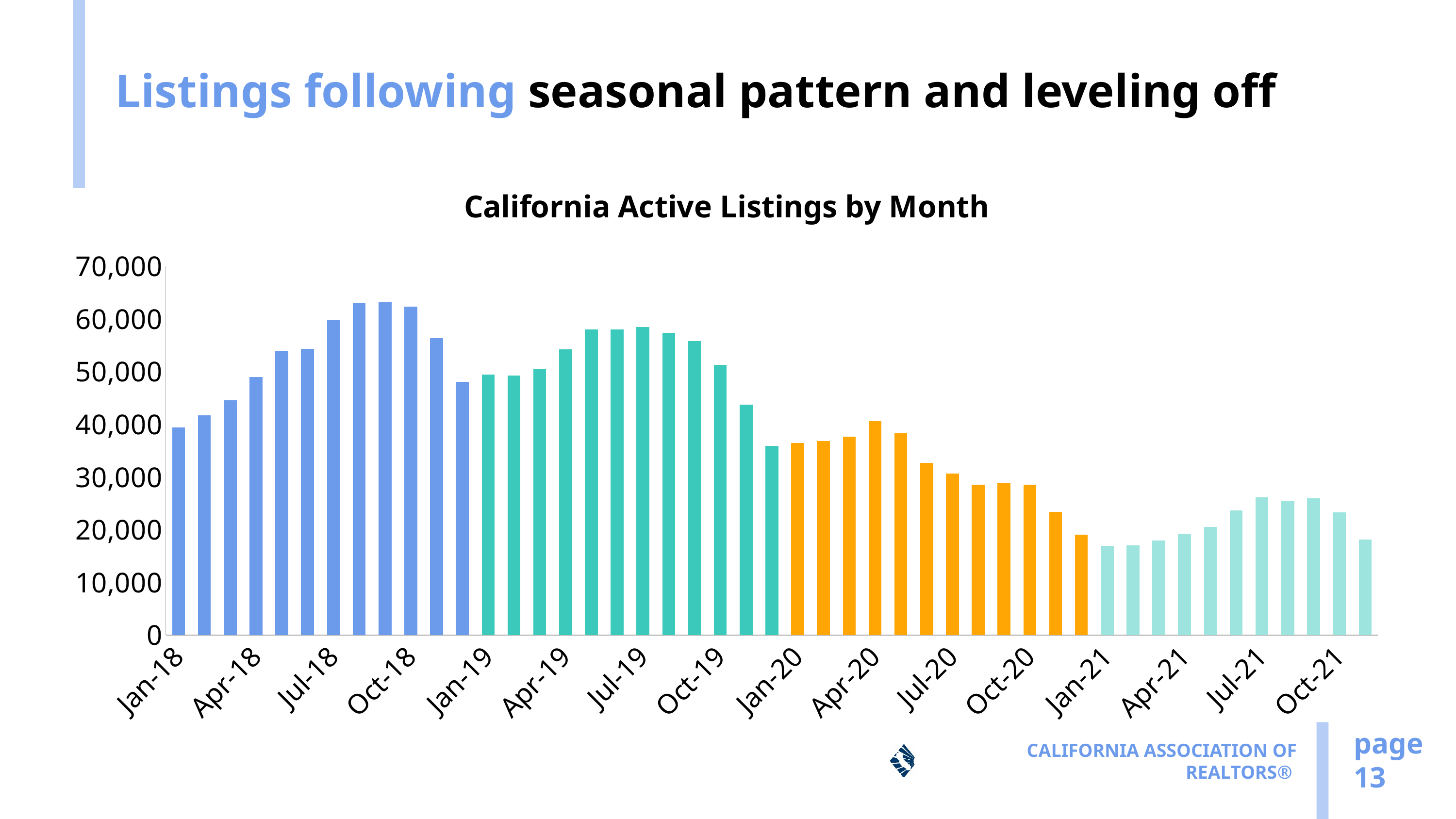
What kind of chart is shown on the slide? bar chart Which is larger, the value for Oct-18 or the value for Oct-21? Oct-18 What is the title of the chart? California Active Listings by Month How many different bar colours are used in the chart? 4 Do the values generally rise or fall from Apr-20 to Jan-21? fall Is the value for Jul-19 greater or less than 60,000? less Which is larger, the value for Jul-19 or the value for Jul-20? Jul-19 Is the value for Jul-21 greater or less than 20,000? greater Is the value for Jan-20 greater or less than 40,000? less